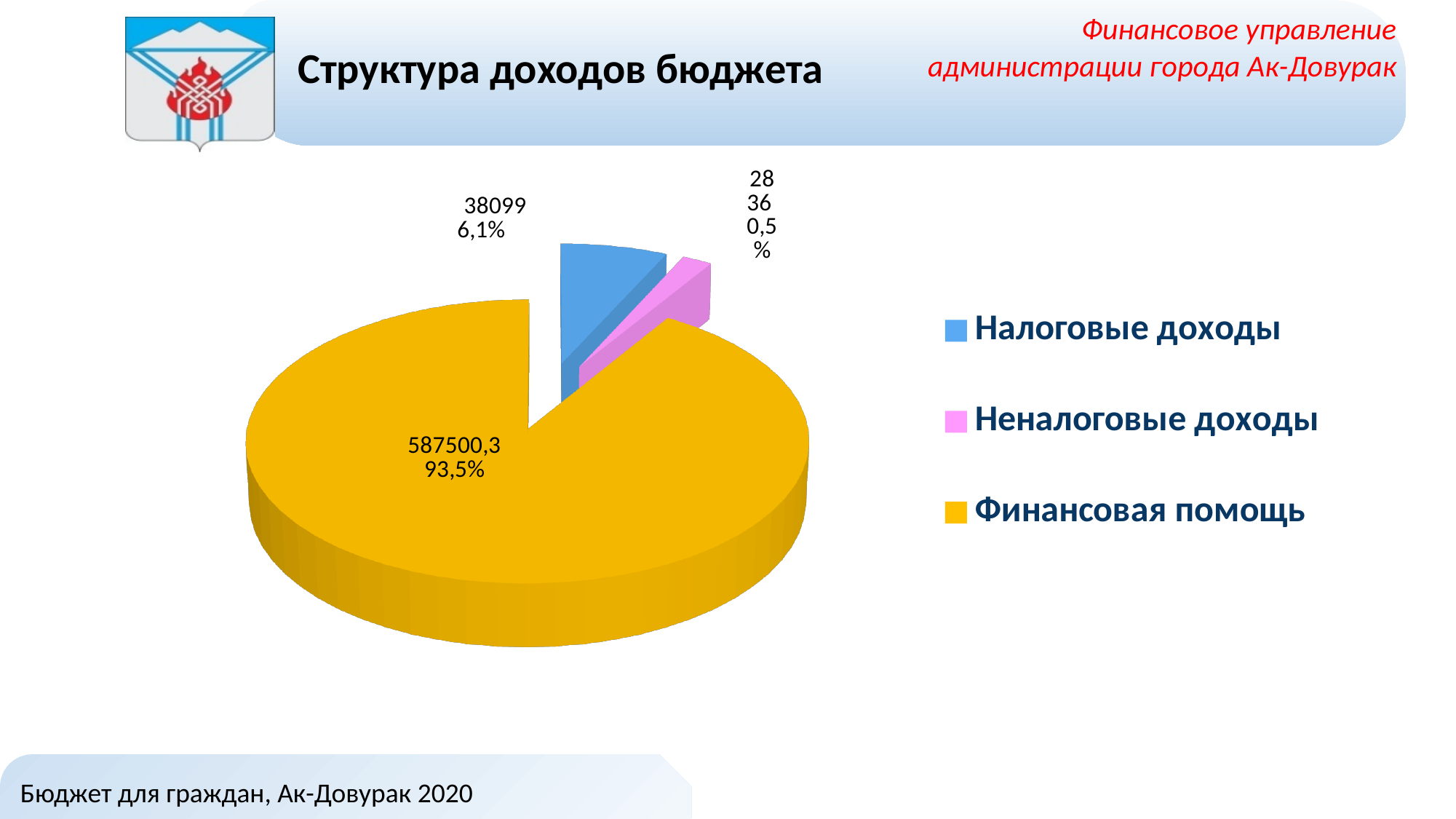
Which category has the largest slice of the pie? Финансовая помощь What share of the pie does Неналоговые доходы take? 0,5% Which is larger, Налоговые доходы or Неналоговые доходы? Налоговые доходы By how many percentage points does the share of Финансовая помощь exceed the share of Налоговые доходы? 87,4% What kind of chart is shown on the slide? pie chart What share of the pie does Финансовая помощь take? 93,5% Which category has the smallest slice of the pie? Неналоговые доходы What is the value shown for Налоговые доходы? 38099 What is the value shown for Финансовая помощь? 587500,3 How many slices does the pie chart have? 3 What is the title of the chart? Структура доходов бюджета What share of the pie does Налоговые доходы take? 6,1%